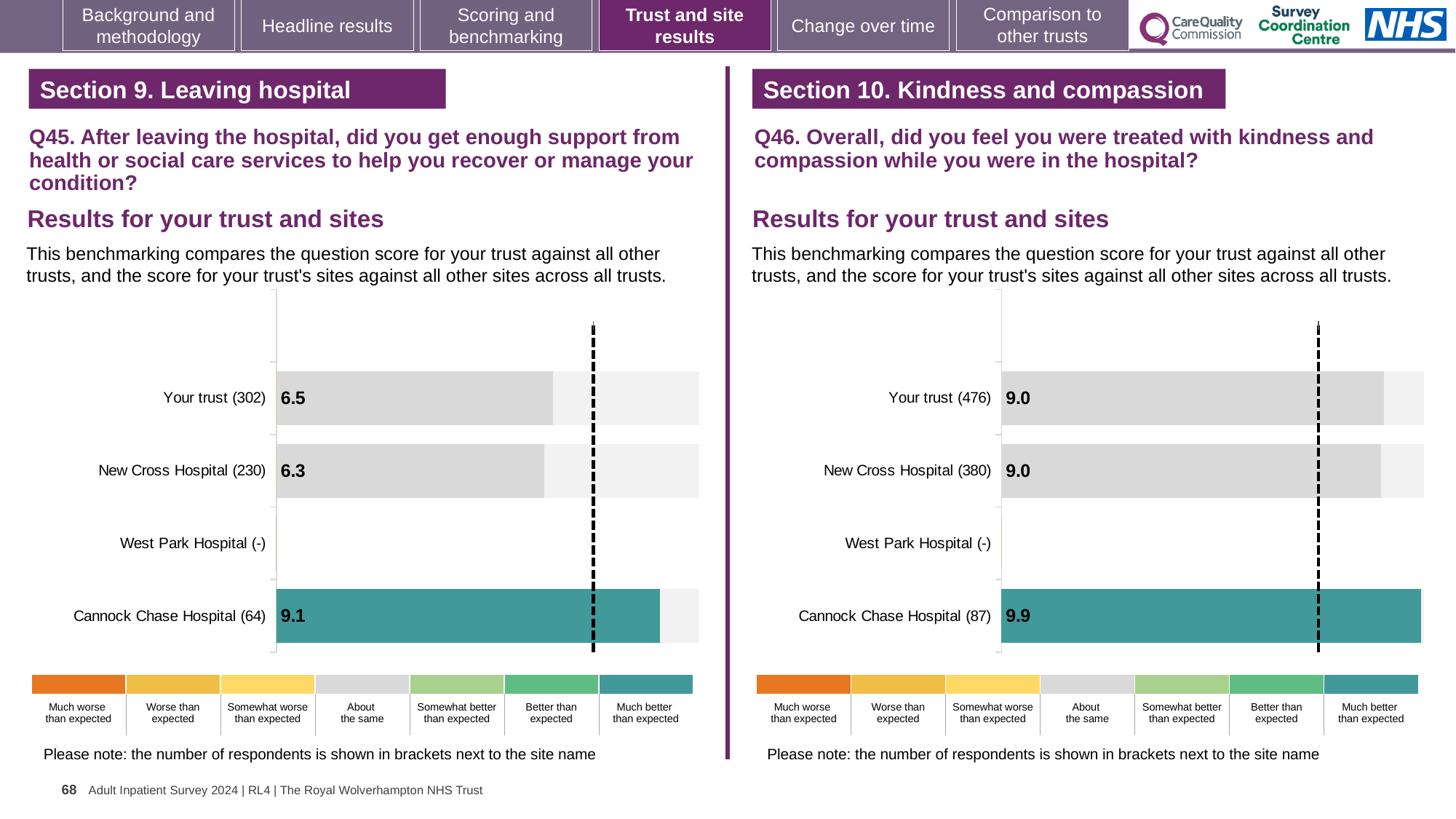
In the Q45 chart on the left, how many respondents are shown in brackets for Cannock Chase Hospital? 64 In the Q46 chart on the right, which is higher: the score for Your trust or the score for Cannock Chase Hospital? Cannock Chase Hospital In the Q46 chart on the right, what is the difference between the Cannock Chase Hospital score and the New Cross Hospital score? 0.9 In the Q46 chart on the right, what is the score for New Cross Hospital? 9.0 In the Q45 chart on the left, what is the difference between the Cannock Chase Hospital score and the Your trust score? 2.6 In the Q46 chart on the right, what is the score for Cannock Chase Hospital? 9.9 How many site rows (including Your trust) are listed in the Q45 chart on the left? 4 What kind of chart is used for the Q46 results on the right? Bar chart In the Q45 chart on the left, which of the plotted bars has the lowest score? New Cross Hospital In the Q45 chart on the left, what is the score for Your trust? 6.5 In the Q45 chart on the left, which site has the highest score? Cannock Chase Hospital In the Q45 chart on the left, what is the score for Cannock Chase Hospital? 9.1